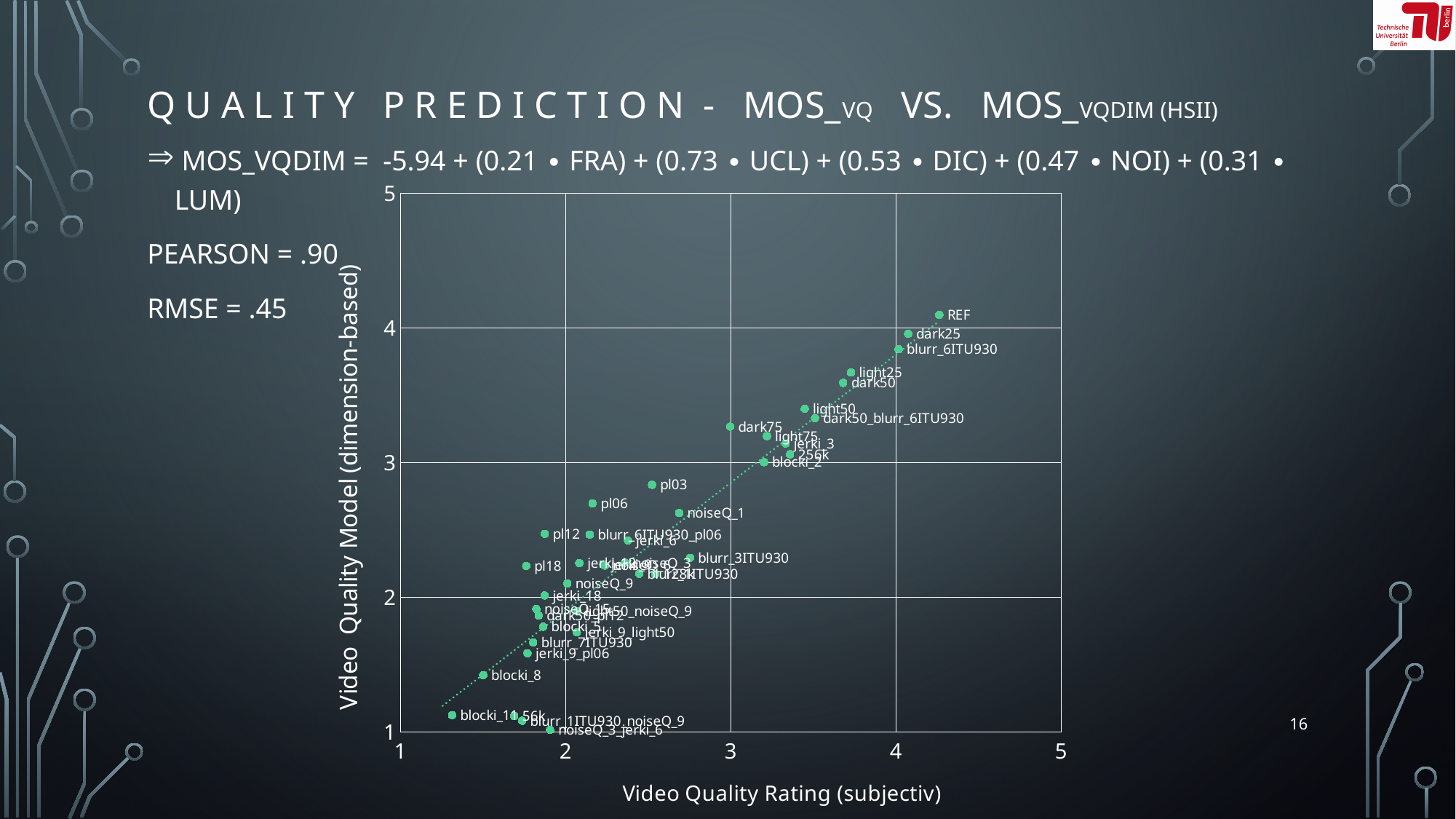
Which point has a higher vertical-axis value, dark25 or dark50? dark25 What kind of chart is shown on the slide? scatter plot Is the vertical-axis value for REF greater or less than 4? greater Is the vertical-axis value for dark75 greater or less than 3? greater Is the vertical-axis value for pl03 greater or less than 3? less What is the title of the vertical axis of the chart? Video Quality Model (dimension-based) Which labeled point has the highest value on the vertical axis? REF Do the plotted points generally rise or fall as the horizontal-axis value increases? rise What is the title of the horizontal axis of the chart? Video Quality Rating (subjectiv)